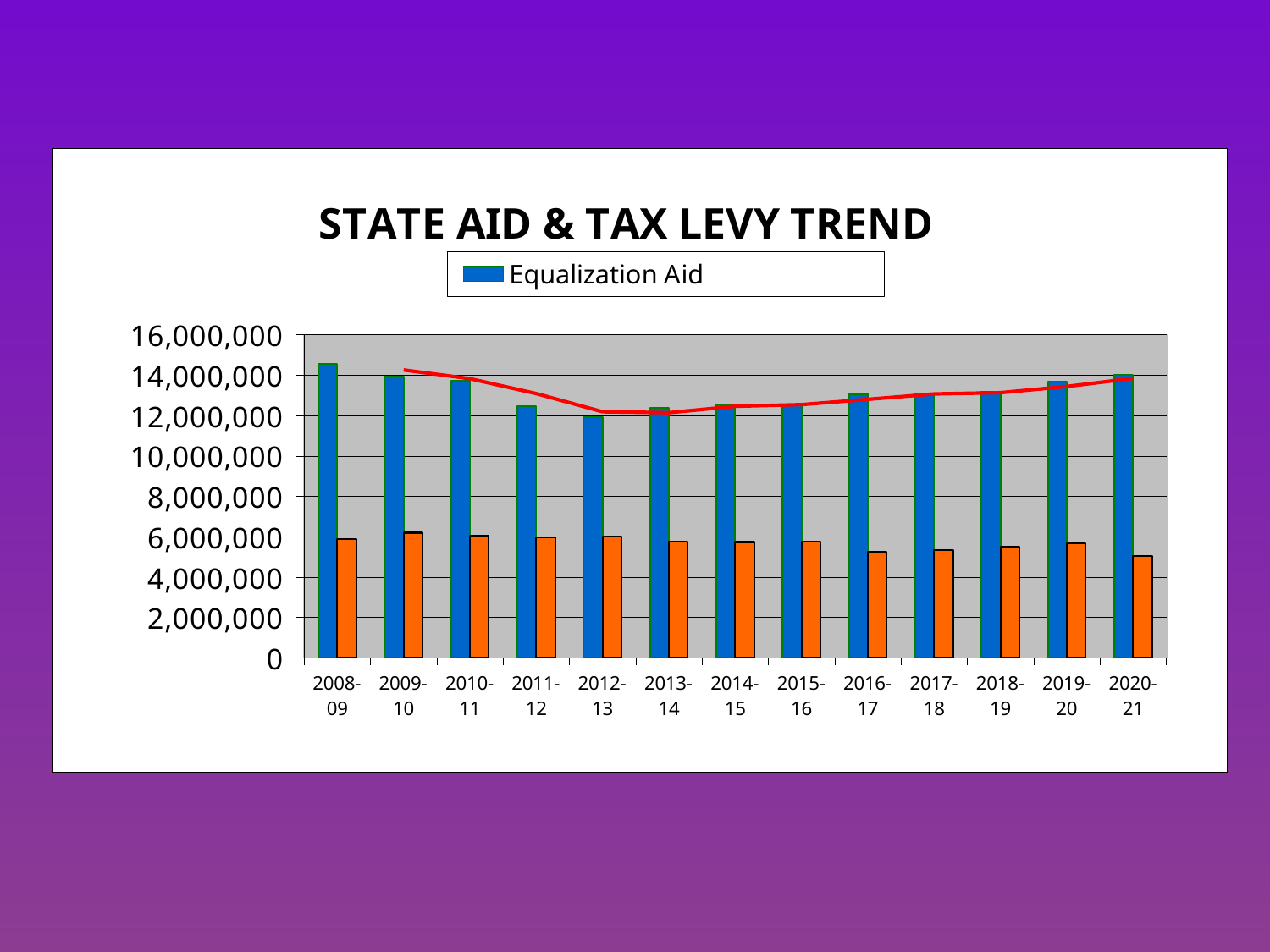
Do the Equalization Aid bars rise or fall from 2008-09 to 2012-13? fall How many series does the legend list? 1 Is the orange bar value for 2020-21 greater or less than 6,000,000? less Which year has the larger Equalization Aid value, 2008-09 or 2012-13? 2008-09 Which year has the highest Equalization Aid bar? 2008-09 Which year has the lowest orange bar? 2020-21 How many school years are shown along the x axis? 13 Is the orange bar value for 2009-10 greater or less than 6,000,000? greater Which year has the lowest Equalization Aid bar? 2012-13 What kind of chart is shown on the slide? bar chart What is the title of the chart? STATE AID & TAX LEVY TREND Is the Equalization Aid value for 2008-09 greater or less than 14,000,000? greater